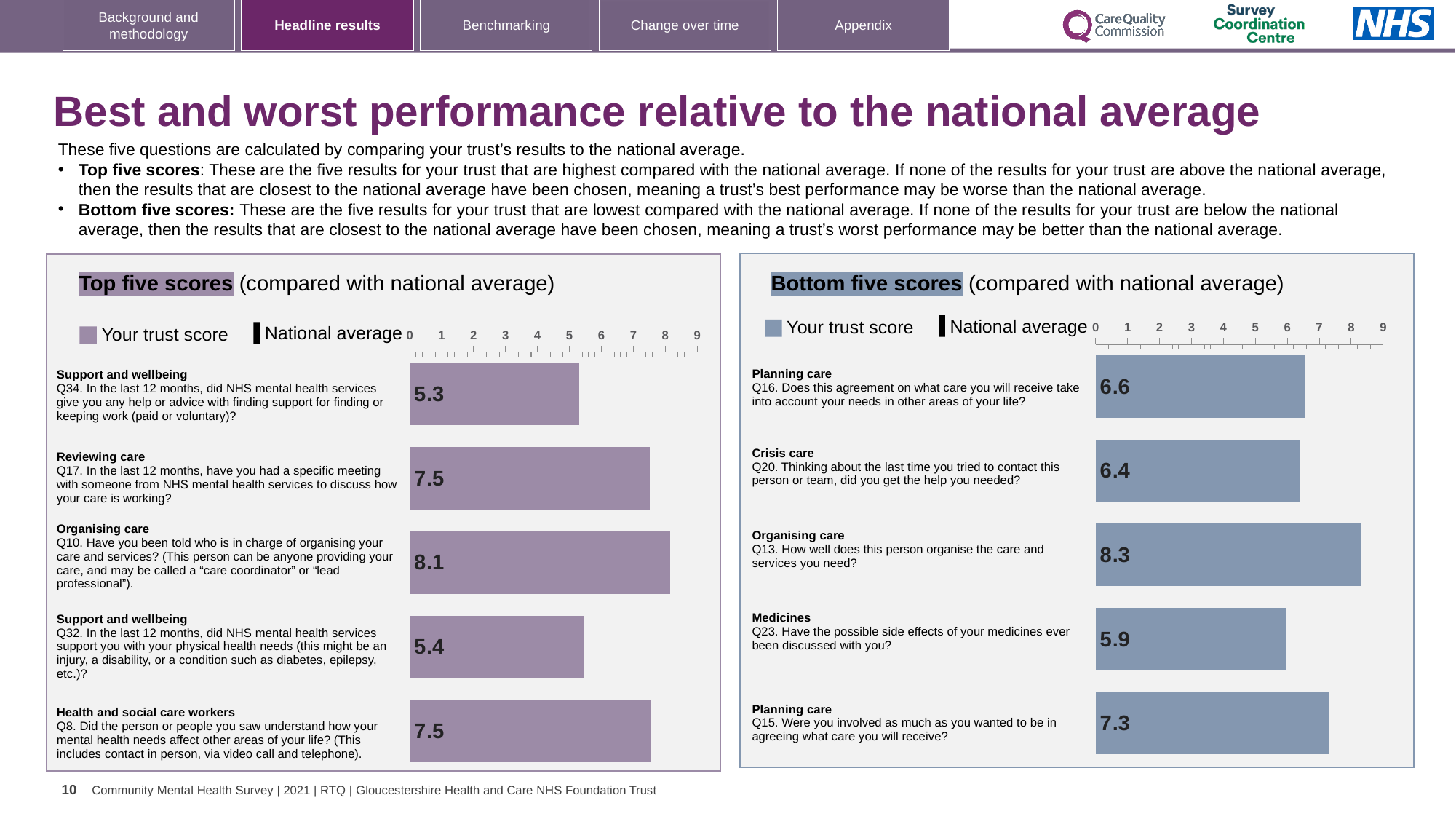
In the Top five scores chart, what is the trust score for Q10 (Organising care)? 8.1 In the Bottom five scores chart, which question has the highest trust score? Q13 (Organising care) In the Bottom five scores chart, which is larger: the trust score for Q13 or for Q15? Q13 In the Bottom five scores chart, which question has the lowest trust score? Q23 (Medicines) In the Top five scores chart, what is the difference between the trust scores for Q10 and Q34? 2.8 In the Top five scores chart, which question has the highest trust score? Q10 (Organising care) In the Top five scores chart, what is the trust score for Q34 (Support and wellbeing)? 5.3 What kind of chart is the Bottom five scores chart? Bar chart In the Bottom five scores chart, what is the trust score for Q23 (Medicines)? 5.9 How many questions are plotted in the Top five scores chart? 5 In the Bottom five scores chart, what is the trust score for Q15 (Planning care)? 7.3 In the Bottom five scores chart, what is the difference between the trust scores for Q16 and Q20? 0.2